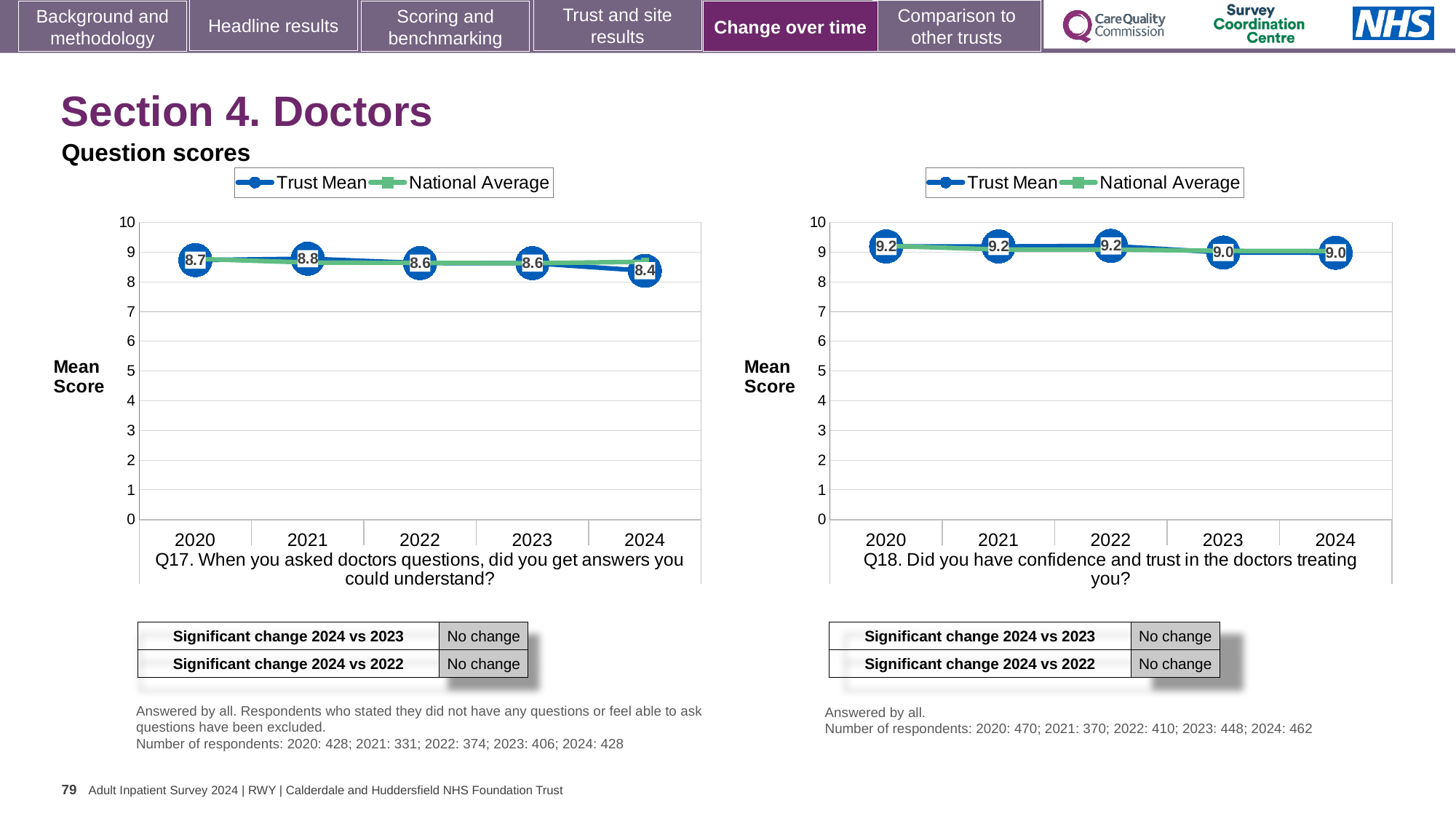
In the Q17 chart, is the National Average value for 2024 greater or less than 8? greater How many years are plotted on the x axis of the Q18 chart? 5 In the Q17 chart, does the Trust Mean score rise or fall from 2021 to 2024? fall In the Q17 chart, which year has the highest Trust Mean score? 2021 In the Q17 chart, what is the Trust Mean score for 2024? 8.4 How many series does the legend of the Q17 chart list? 2 In the Q17 chart, which year has the lowest Trust Mean score? 2024 In the Q18 chart, is the Trust Mean score for 2020 larger or smaller than the Trust Mean score for 2024? larger What kind of chart is the Q18 chart? line chart In the Q18 chart, what is the difference between the Trust Mean scores for 2022 and 2023? 0.2 In the Q17 chart, what is the difference between the Trust Mean scores for 2021 and 2024? 0.4 In the Q18 chart, what is the Trust Mean score for 2020? 9.2